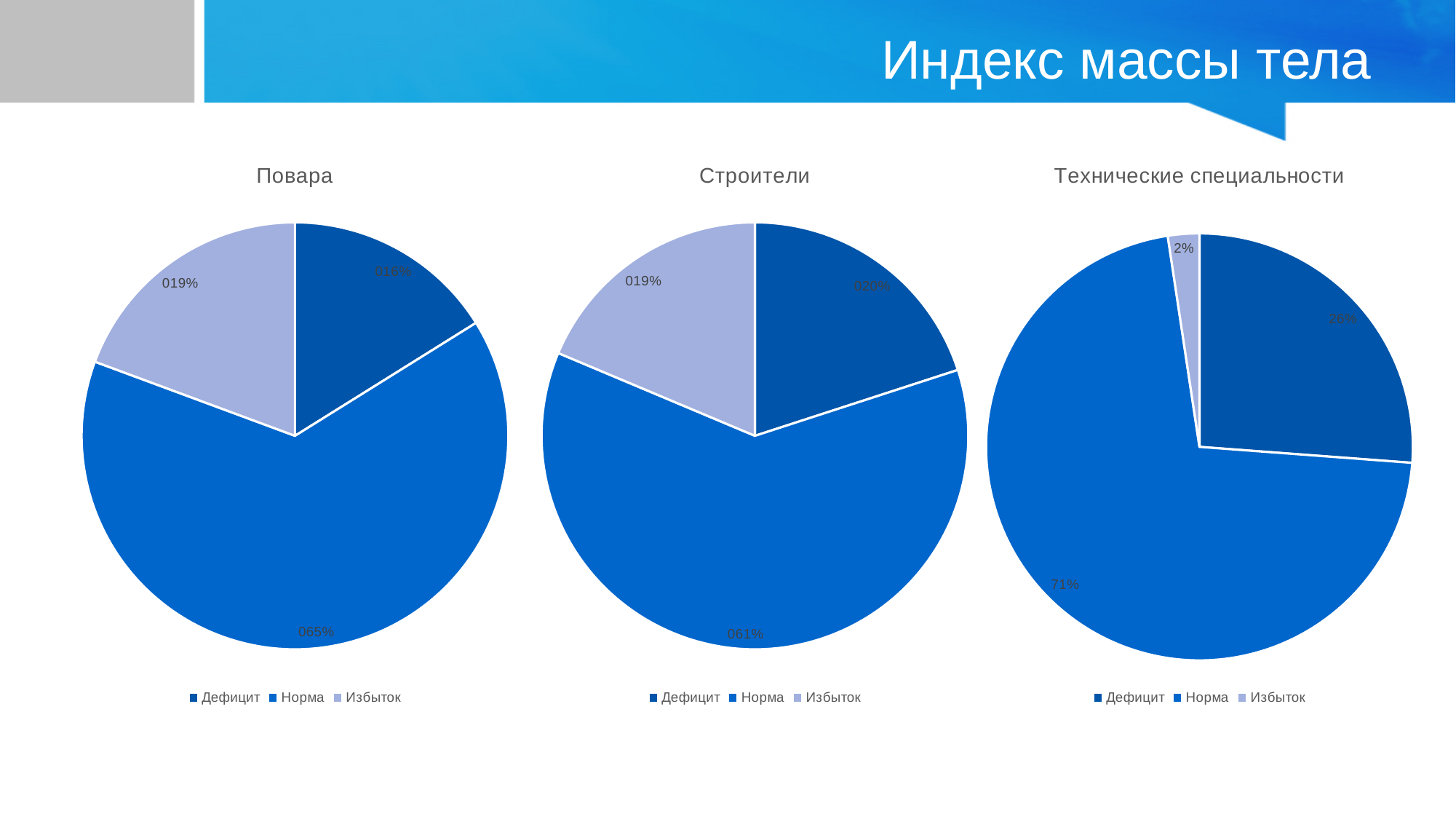
In the "Повара" chart, what value is shown for Избыток? 019% In the "Строители" chart, what value is shown for Норма? 061% How many entries does the legend of the "Повара" chart list? 3 In the "Технические специальности" chart, which category has the largest slice? Норма In the "Технические специальности" chart, what value is shown for Избыток? 2% In the "Повара" chart, what value is shown for Норма? 065% In the "Повара" chart, which category has the smallest slice? Дефицит How many slices does the "Строители" pie chart have? 3 What kind of chart is used for the "Повара" chart? pie chart In the "Технические специальности" chart, what value is shown for Дефицит? 26% In the "Строители" chart, which is larger, Дефицит or Избыток? Дефицит In the "Строители" chart, what value is shown for Дефицит? 020%